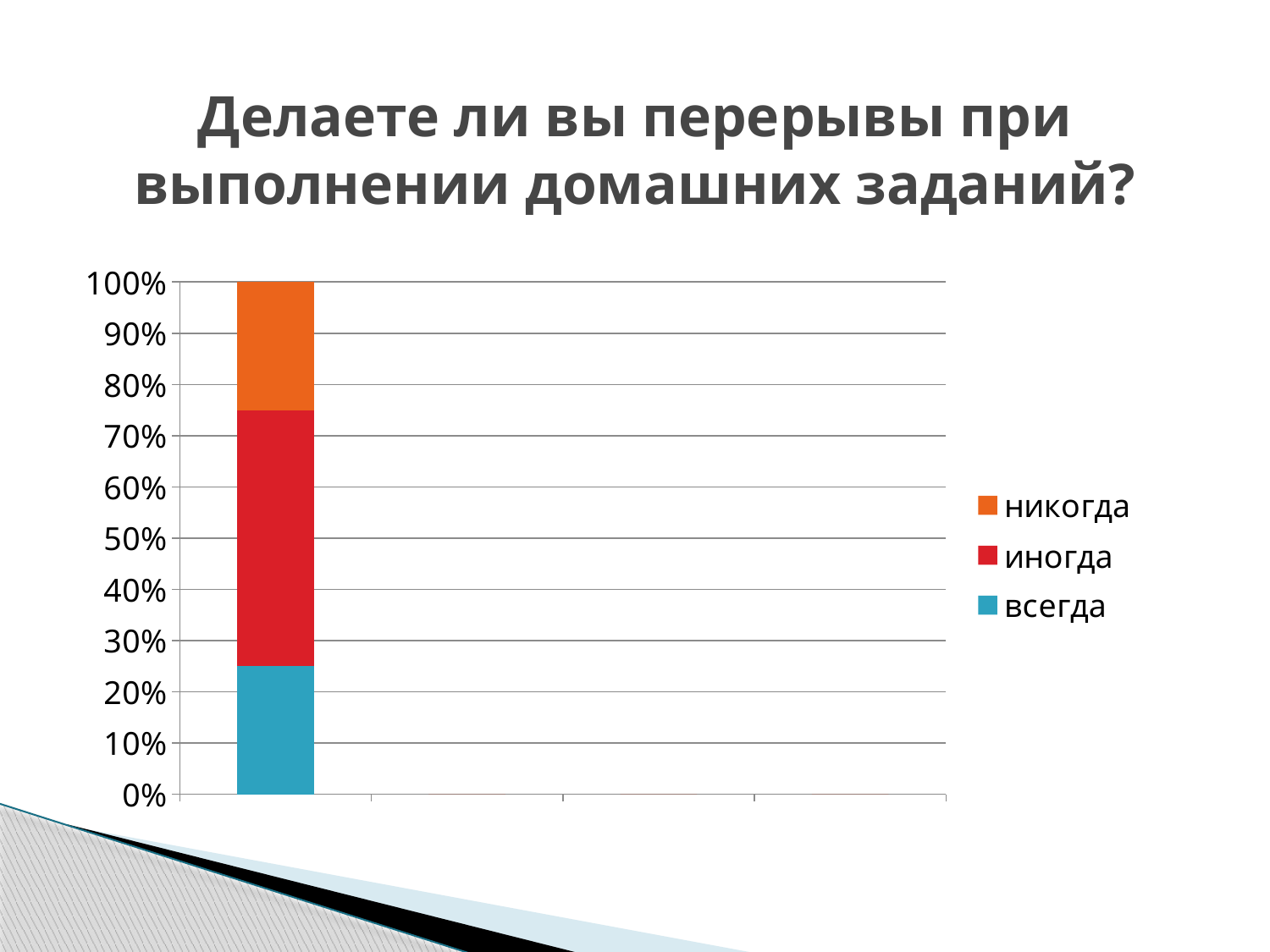
Which is larger in the stacked bar, the share for никогда or the share for иногда? иногда What is the title of the chart? Делаете ли вы перерывы при выполнении домашних заданий? How many series does the legend list? 3 How many stacked bars are plotted in the chart? 1 What kind of chart is shown on the slide? stacked bar chart Is the share for всегда greater or less than 20%? greater Which is larger in the stacked bar, the share for иногда or the share for всегда? иногда Is the share for иногда greater or less than 40%? greater Which series is shown in red in the legend? иногда Which series takes up the largest share of the stacked bar? иногда Is the share for никогда greater or less than 30%? less